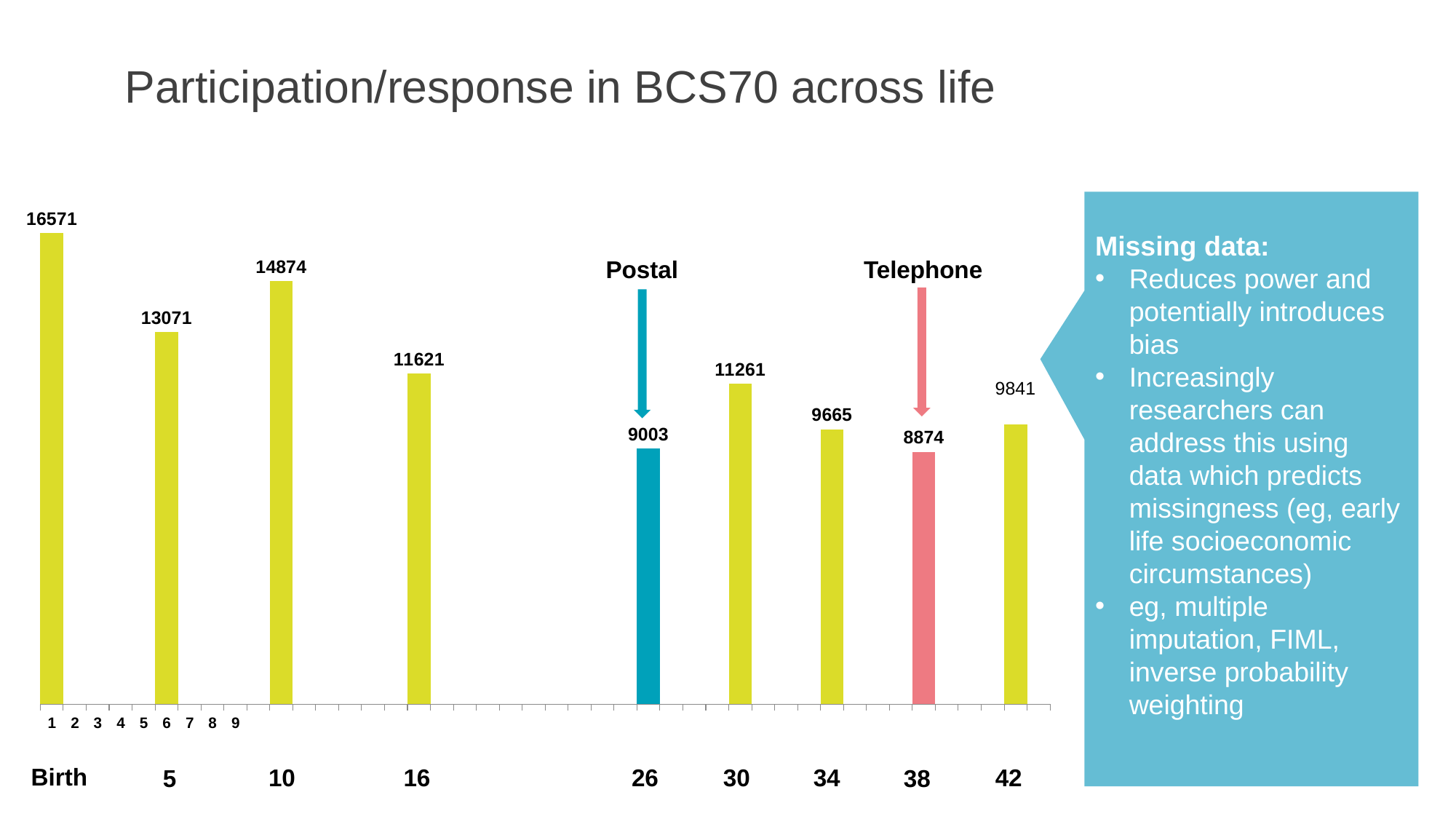
Which is larger, participation at age 30 or at age 34? 30 What is the participation value at age 38? 8874 What is the participation value at age 42? 9841 How many age points (bars) are shown in the chart? 9 What is the difference between participation at Birth and at age 42? 6730 What is the difference between participation at age 10 and at age 16? 3253 What kind of chart is shown on the slide? Bar chart Which age point has the highest participation? Birth Which survey mode is labelled for the bar at age 26? Postal What is the participation value at Birth? 16571 What is the participation value at age 26? 9003 Which age point has the lowest participation? 38